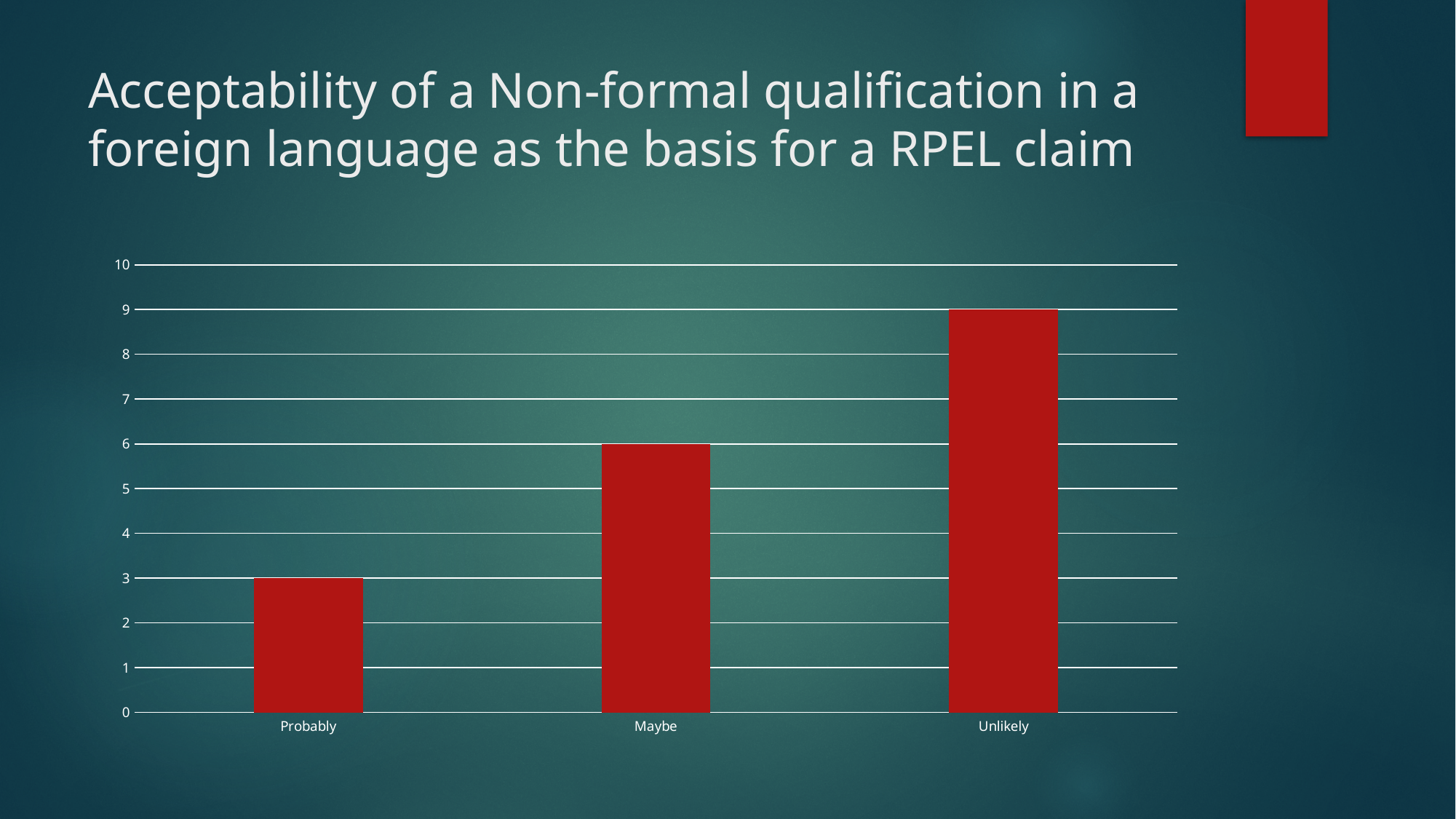
How many categories are shown on the x axis? 3 What is the difference between the values for Maybe and Probably? 3 Do the values rise or fall from Probably to Unlikely along the x axis? rise Is the value for Maybe greater or less than 5? greater Which category has the highest value? Unlikely What kind of chart is shown on the slide? bar chart What is the value for Maybe? 6 Which is larger, the value for Maybe or the value for Unlikely? Unlikely What is the value for Unlikely? 9 What is the difference between the values for Unlikely and Probably? 6 Which category has the lowest value? Probably What is the value for Probably? 3